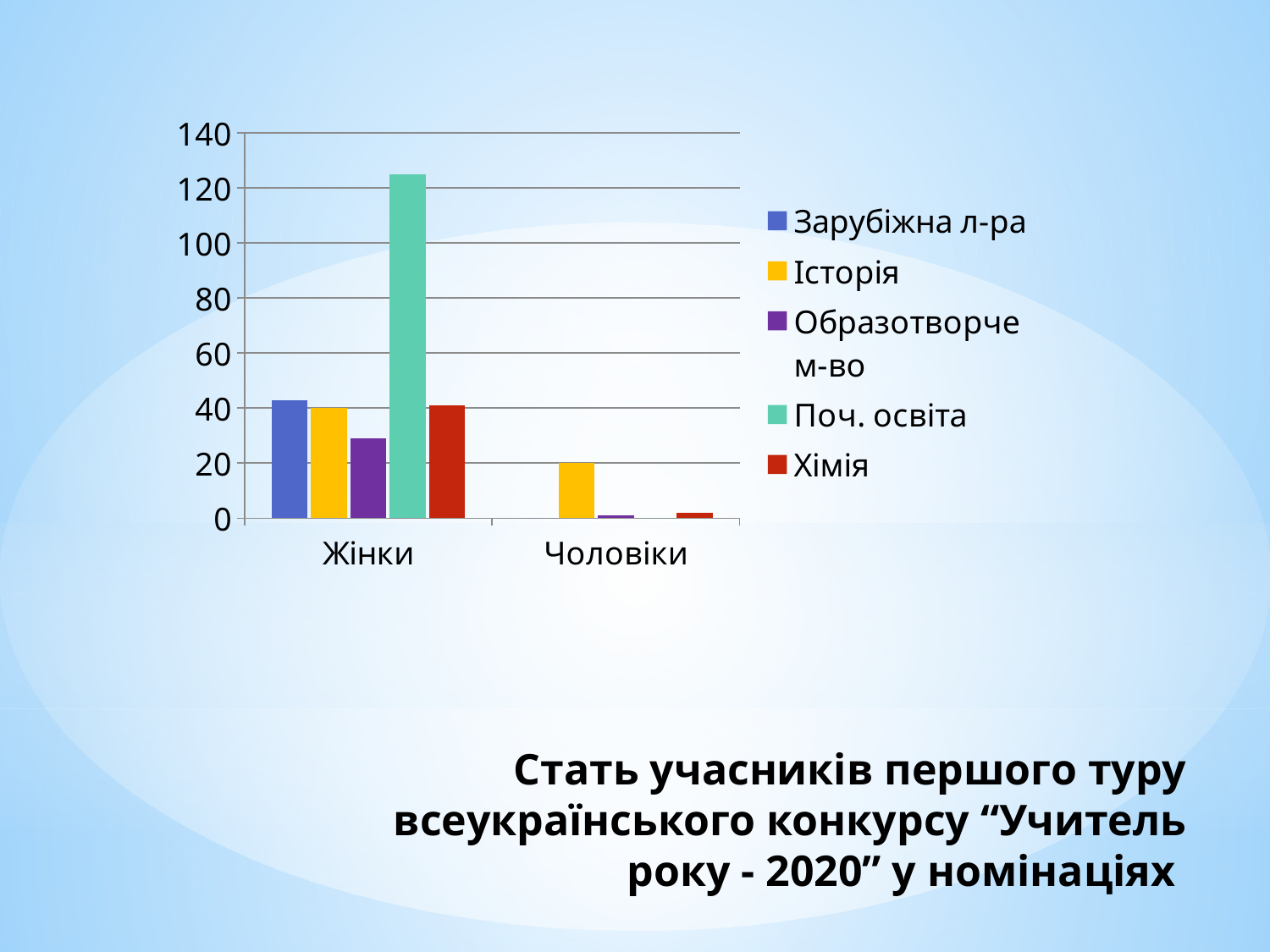
How many categories are shown on the x axis? 2 How many series does the legend list? 5 Is the value for Поч. освіта for Жінки greater or less than 120? greater Which is larger for Жінки: Зарубіжна л-ра or Образотворче м-во? Зарубіжна л-ра Which series has the highest value for Жінки? Поч. освіта What colour are the bars for Поч. освіта? teal (green) Which series has the lowest value for Жінки? Образотворче м-во Is the value for Хімія for Чоловіки greater or less than 20? less Which is larger for Жінки: Поч. освіта or Хімія? Поч. освіта What kind of chart is shown on the slide? bar chart Which series has the highest value for Чоловіки? Історія Is the value for Образотворче м-во for Жінки greater or less than 40? less